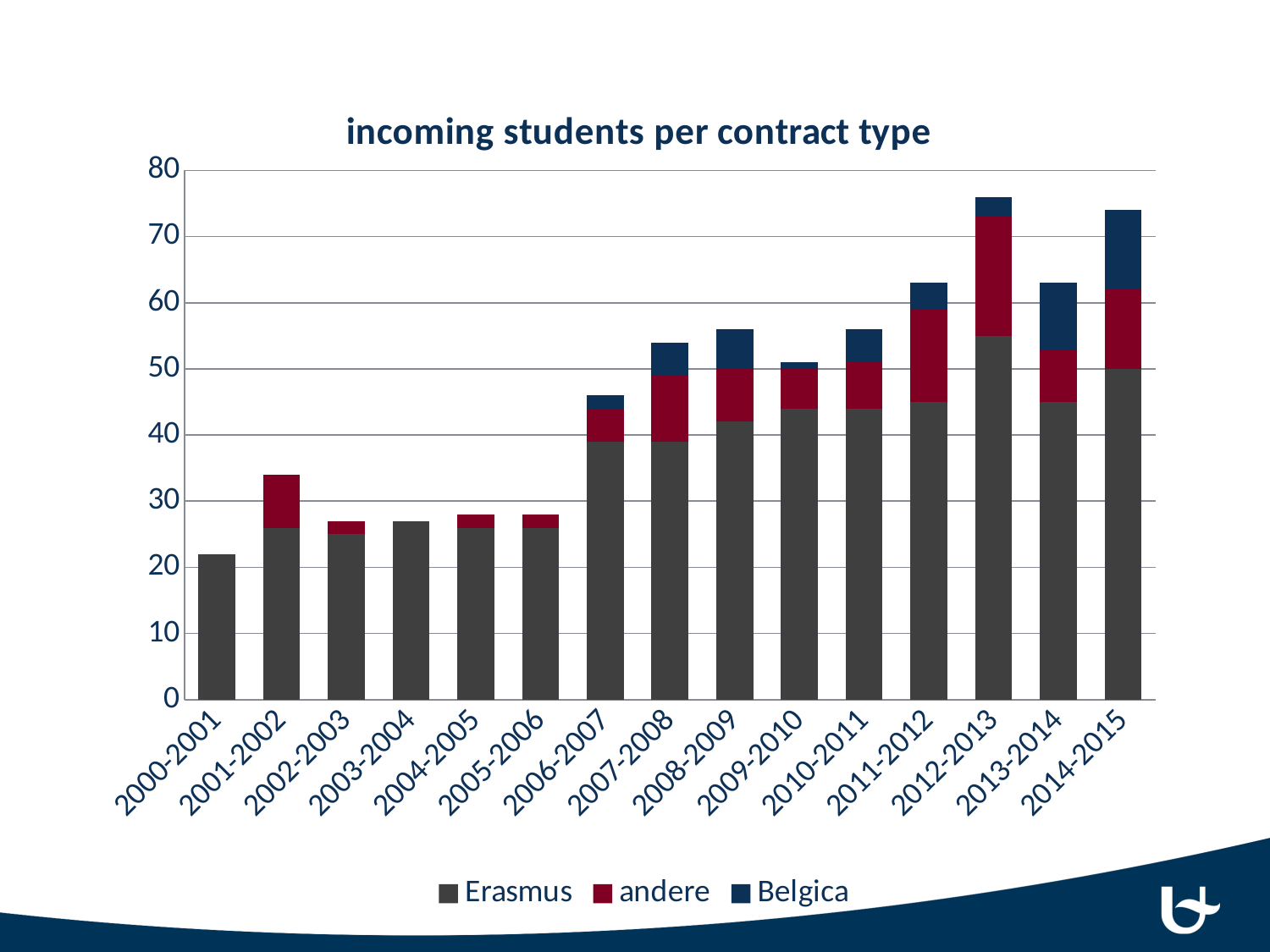
Is the total for 2003-2004 greater or less than 30? less Which has the larger total, 2001-2002 or 2002-2003? 2001-2002 What is the title of the chart? incoming students per contract type Is the total for 2012-2013 greater or less than 70? greater Do the total numbers of incoming students generally rise or fall from 2000-2001 to 2014-2015? rise What kind of chart is shown on the slide? Stacked bar chart Is the total for 2006-2007 greater or less than 40? greater Which academic year has the lowest total number of incoming students? 2000-2001 How many academic years are shown on the x axis? 15 How many series does the legend list? 3 Which has the larger total, 2009-2010 or 2010-2011? 2010-2011